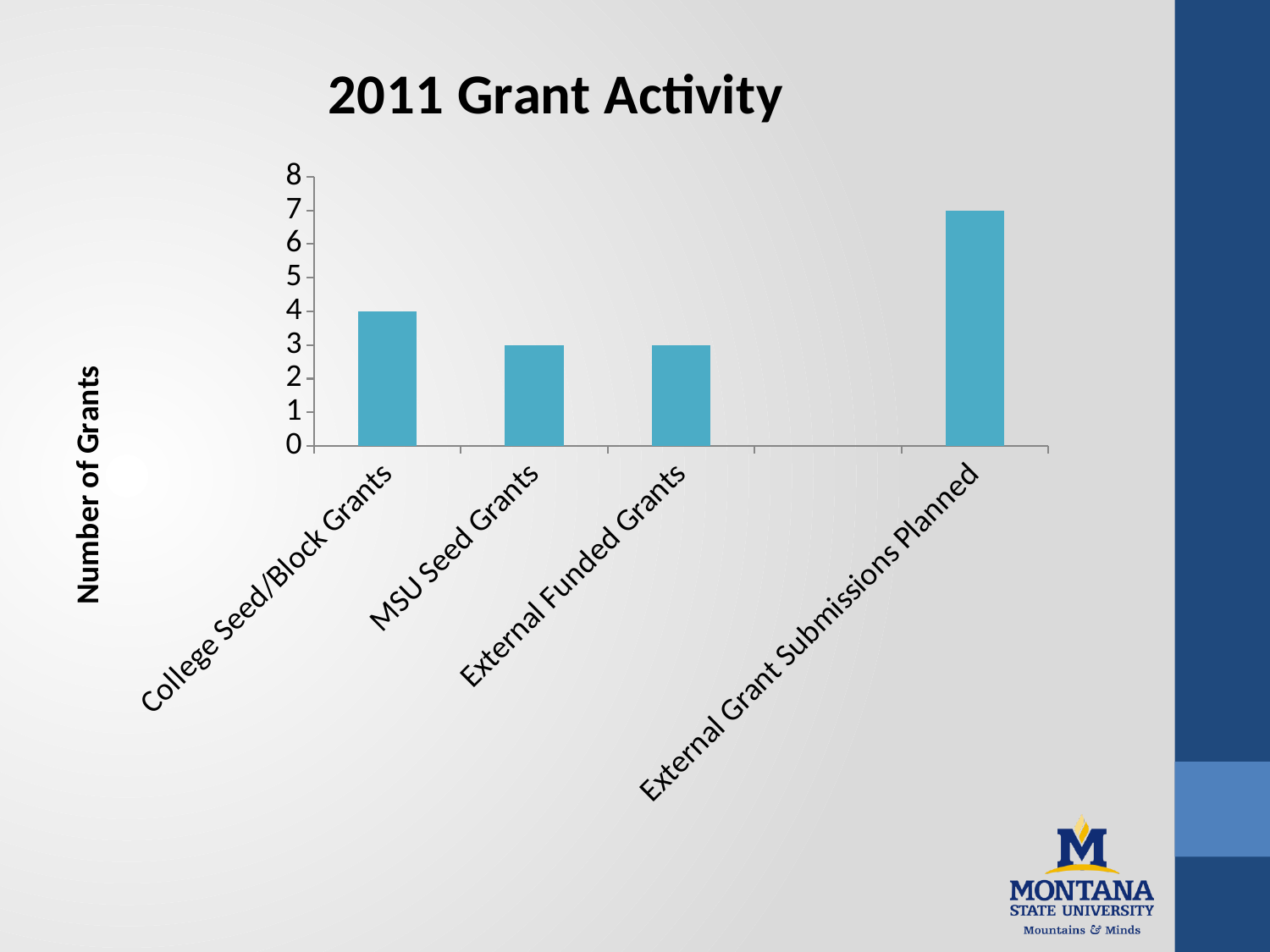
What kind of chart is shown on the slide? bar chart What is the number of grants for College Seed/Block Grants? 4 What is the difference between External Grant Submissions Planned and College Seed/Block Grants? 3 What is the number of grants for External Funded Grants? 3 What is the title of the chart? 2011 Grant Activity Is the value for External Grant Submissions Planned greater or less than 5? greater How many categories are shown on the chart? 4 What is the number of External Grant Submissions Planned? 7 Which category has the highest number of grants? External Grant Submissions Planned What is the difference between College Seed/Block Grants and MSU Seed Grants? 1 What is the number of grants for MSU Seed Grants? 3 Which is larger, College Seed/Block Grants or External Funded Grants? College Seed/Block Grants